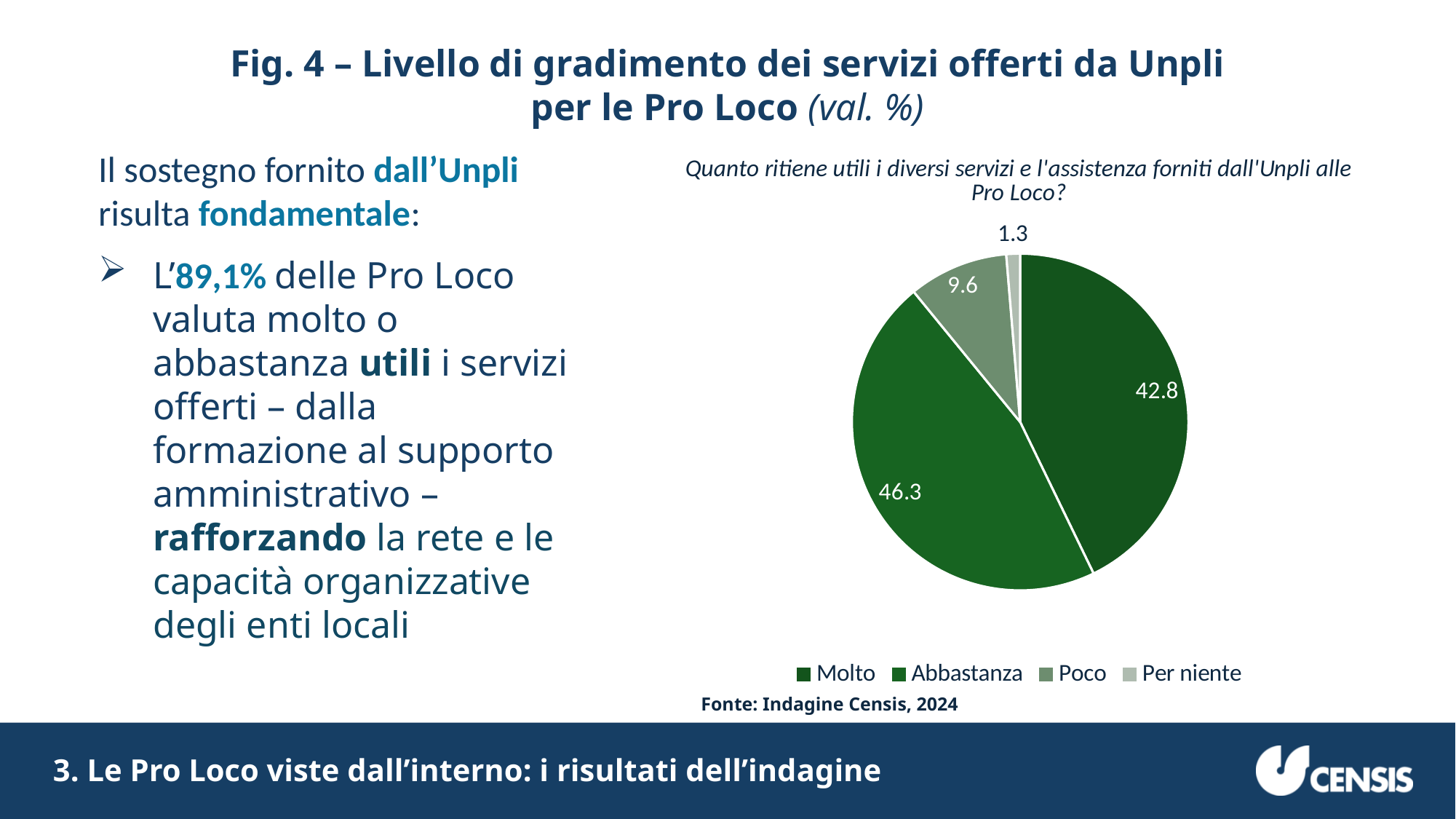
What is the value for Abbastanza? 46.3 What is the value for Molto? 42.8 What is the value for Poco? 9.6 What is the source cited below the chart? Fonte: Indagine Censis, 2024 Which category has the largest share of the pie? Abbastanza Which is larger, the value for Poco or the value for Per niente? Poco What is the combined value of Molto and Abbastanza? 89.1 What is the difference between the values for Abbastanza and Molto? 3.5 How many categories does the legend list? 4 What is the value for Per niente? 1.3 Which category has the smallest share of the pie? Per niente What type of chart is shown on the slide? Pie chart